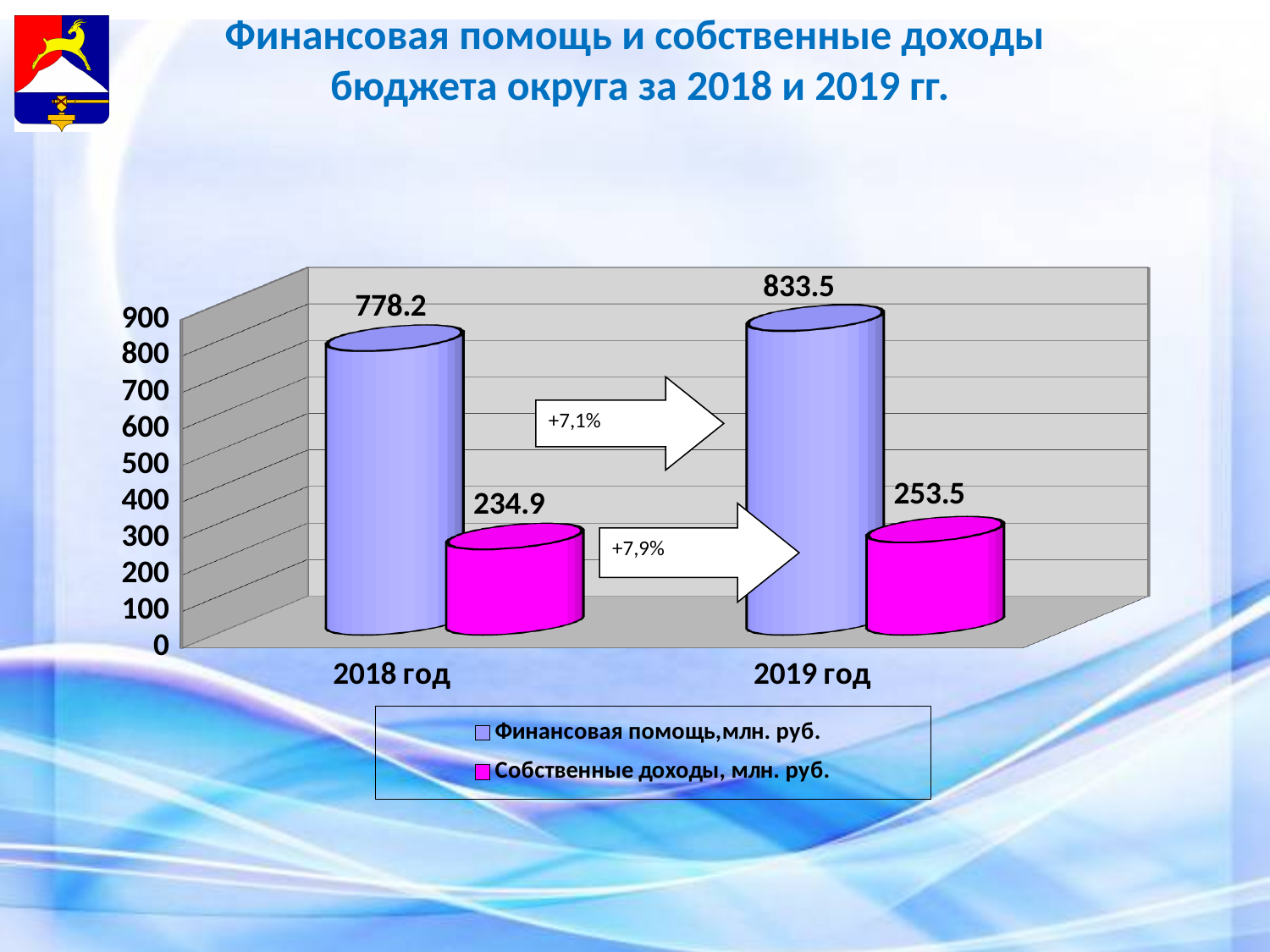
What percentage change is shown by the arrow between the Финансовая помощь bars? +7,1% What is the difference between Финансовая помощь, млн. руб. in 2019 год and 2018 год? 55.3 In which year is Финансовая помощь, млн. руб. higher? 2019 год Which is larger in 2019 год: Финансовая помощь or Собственные доходы? Финансовая помощь How many series does the legend list? 2 What is the value of Финансовая помощь, млн. руб. for 2018 год? 778.2 What is the value of Собственные доходы, млн. руб. for 2018 год? 234.9 What kind of chart is shown on the slide? Bar chart What is the difference between Собственные доходы, млн. руб. in 2019 год and 2018 год? 18.6 In which year is Собственные доходы, млн. руб. lower? 2018 год What is the value of Собственные доходы, млн. руб. for 2019 год? 253.5 What is the value of Финансовая помощь, млн. руб. for 2019 год? 833.5